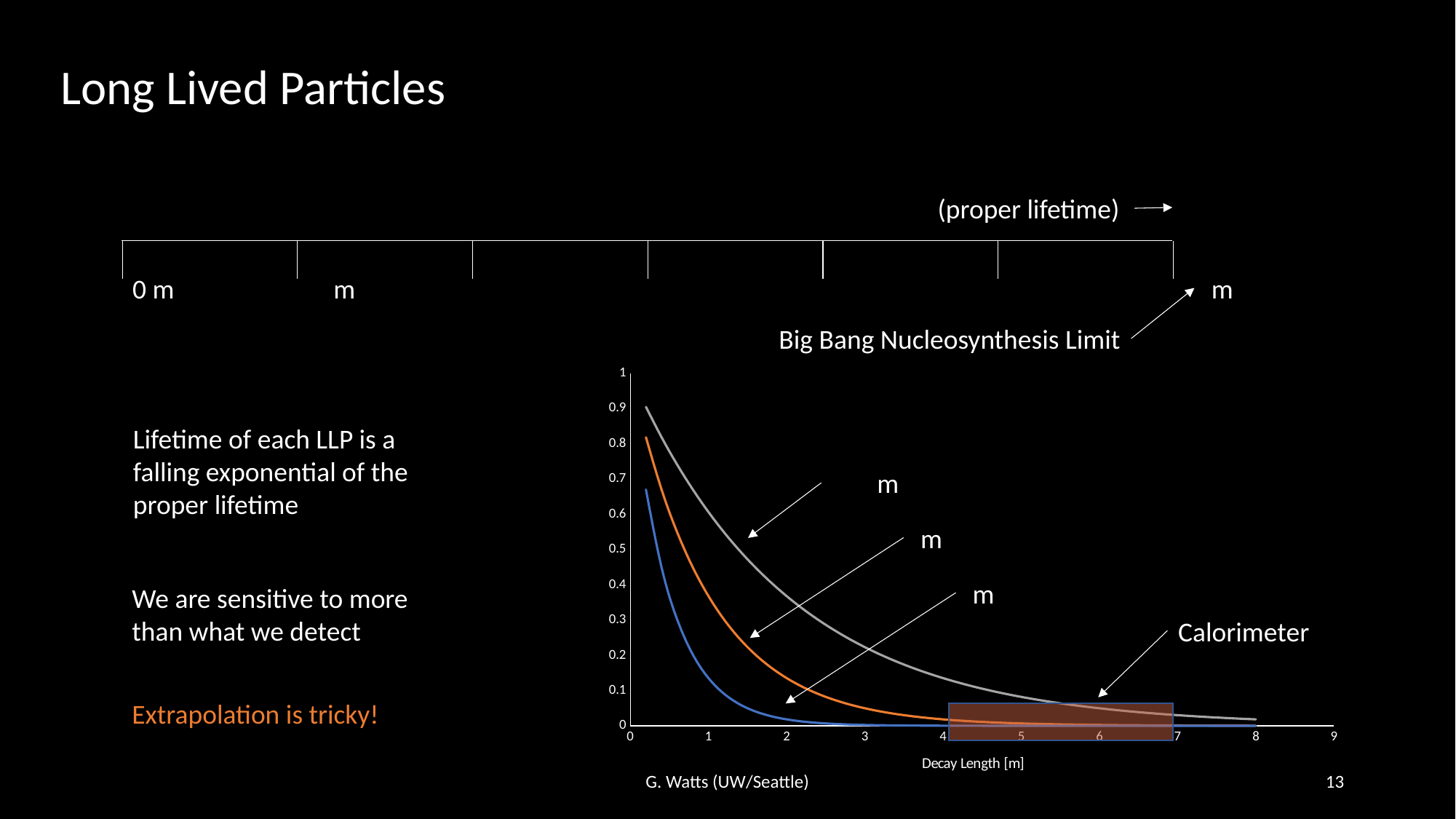
Is the value of the gray curve at a decay length of 2 m greater or less than 0.3? greater What is the highest value shown on the x axis of the chart? 9 Do the curves rise or fall as decay length increases? fall At a decay length of 1 m, which curve has the highest value: gray, orange or blue? gray What kind of chart is shown on the slide? line chart What is the label of the x axis of the chart? Decay Length [m] How many curves are plotted on the chart? 3 Is the value of the blue curve at a decay length of 2 m greater or less than 0.1? less Is the value of the gray curve at a decay length of 0 m greater or less than 0.8? greater At a decay length of 1 m, which curve has the lowest value: gray, orange or blue? blue At a decay length of 2 m, which curve has the larger value, the orange curve or the blue curve? orange